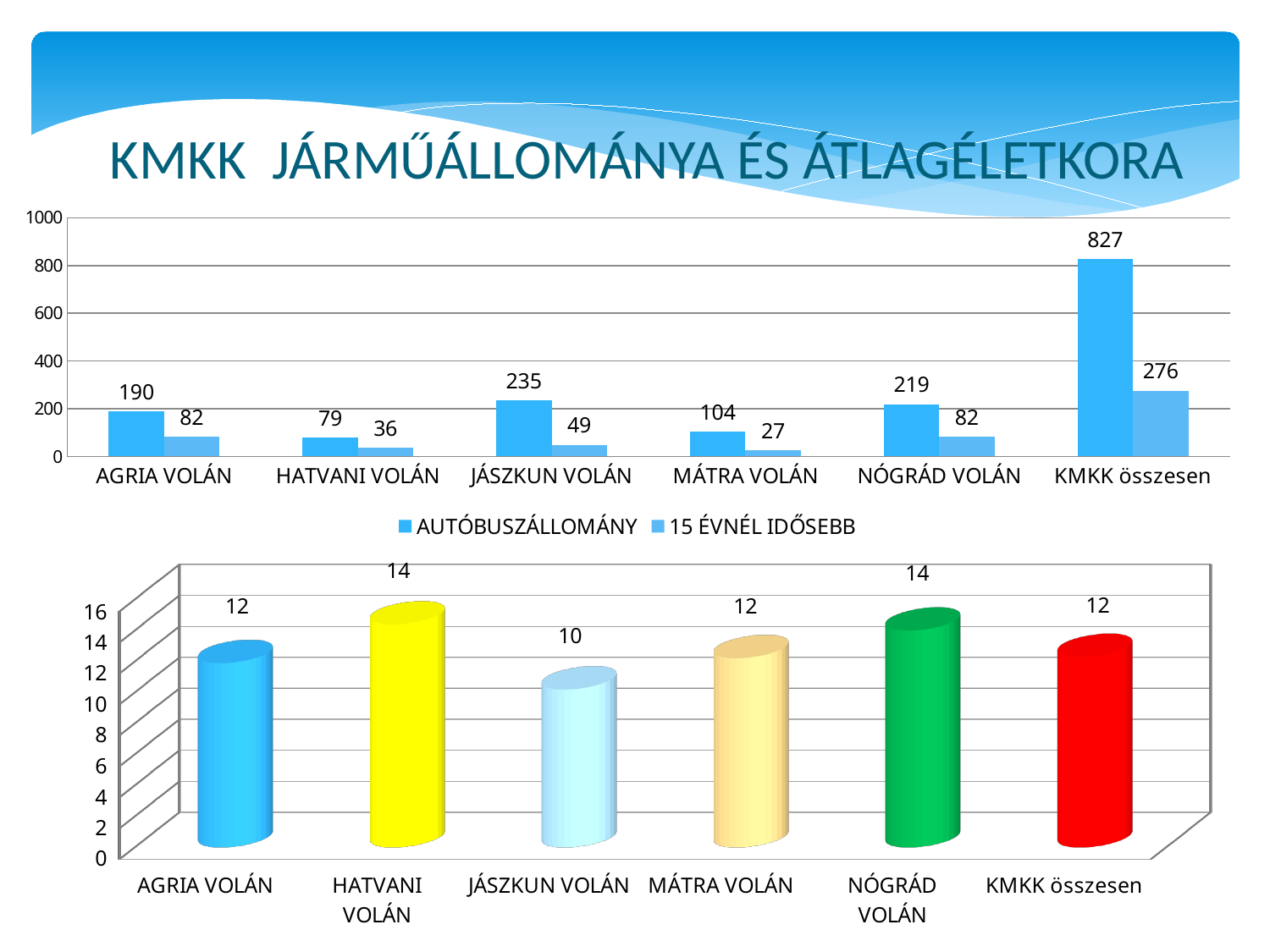
In the top chart, which category has the highest AUTÓBUSZÁLLOMÁNY value? KMKK összesen In the top chart, which is larger: the AUTÓBUSZÁLLOMÁNY value for AGRIA VOLÁN or for HATVANI VOLÁN? AGRIA VOLÁN In the bottom chart, which category has the lowest value? JÁSZKUN VOLÁN What type of chart is the top chart? Bar chart In the top chart, what is the 15 ÉVNÉL IDŐSEBB value for MÁTRA VOLÁN? 27 How many series does the legend of the top chart list? 2 In the top chart, which category has the lowest 15 ÉVNÉL IDŐSEBB value? MÁTRA VOLÁN In the bottom chart, what is the value for JÁSZKUN VOLÁN? 10 In the top chart, what is the difference between the AUTÓBUSZÁLLOMÁNY and 15 ÉVNÉL IDŐSEBB values for NÓGRÁD VOLÁN? 137 How many categories are shown on the x axis of the bottom chart? 6 In the top chart, what is the AUTÓBUSZÁLLOMÁNY value for JÁSZKUN VOLÁN? 235 In the bottom chart, what is the difference between the values for HATVANI VOLÁN and JÁSZKUN VOLÁN? 4